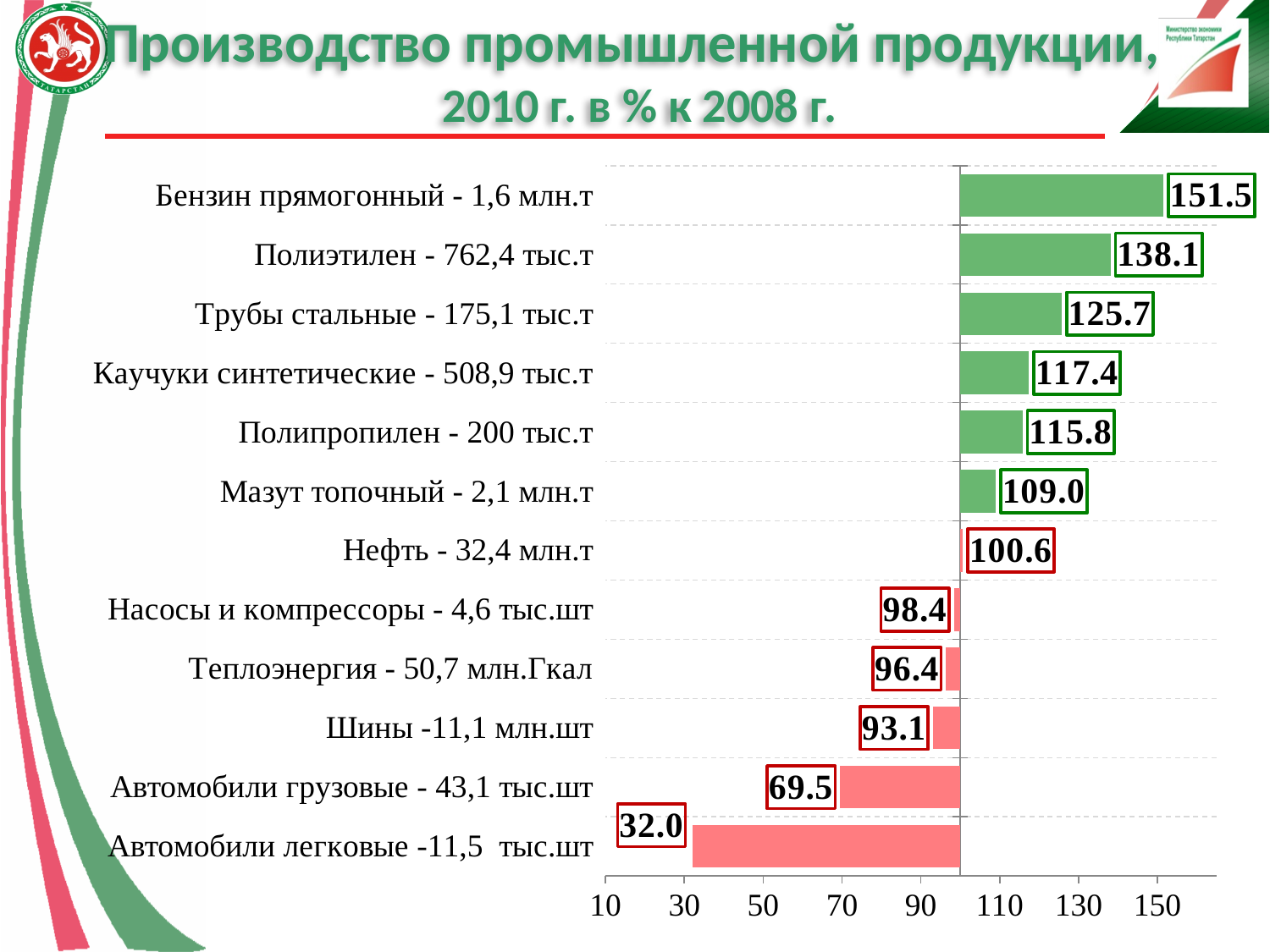
Which is larger, the value for Каучуки синтетические - 508,9 тыс.т or the value for Полипропилен - 200 тыс.т? Каучуки синтетические - 508,9 тыс.т What is the value for Полиэтилен - 762,4 тыс.т? 138.1 What is the difference between the values for Автомобили грузовые - 43,1 тыс.шт and Автомобили легковые -11,5 тыс.шт? 37.5 Which category has the highest value? Бензин прямогонный - 1,6 млн.т What is the title of the chart on the slide? Производство промышленной продукции, 2010 г. в % к 2008 г. What is the difference between the values for Бензин прямогонный - 1,6 млн.т and Полиэтилен - 762,4 тыс.т? 13.4 What kind of chart is shown on the slide? bar chart Is the value for Трубы стальные - 175,1 тыс.т greater or less than 110? greater How many categories are shown in the chart? 12 What is the value for Мазут топочный - 2,1 млн.т? 109.0 What is the value for Автомобили грузовые - 43,1 тыс.шт? 69.5 Which category has the lowest value? Автомобили легковые -11,5 тыс.шт